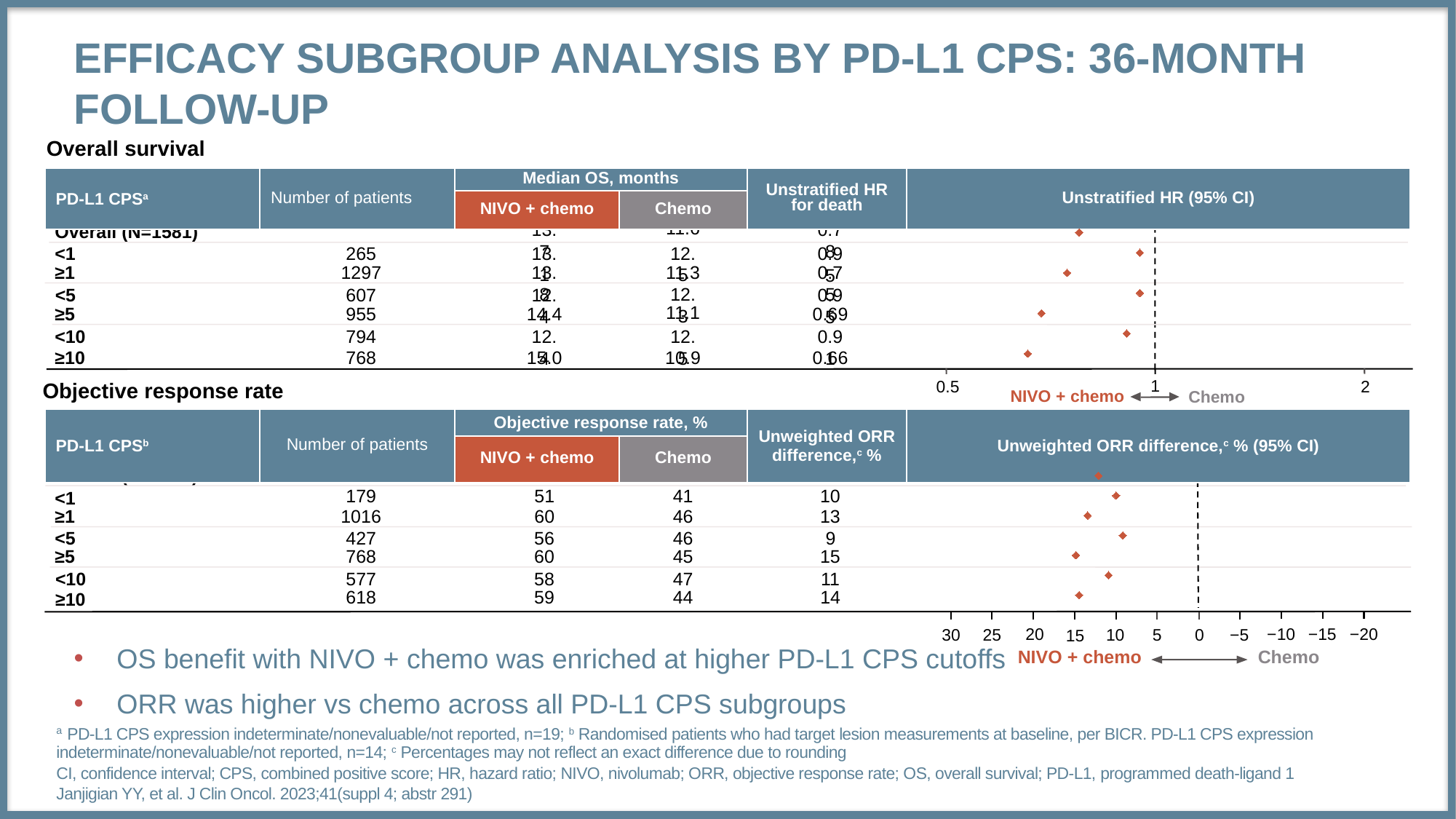
In the Objective response rate table, what is the objective response rate for NIVO + chemo in the PD-L1 CPS ≥10 subgroup? 59 In the Objective response rate table, what is the difference between the NIVO + chemo and Chemo objective response rates for the PD-L1 CPS <1 subgroup? 10 In the Overall survival table, how many patients are in the PD-L1 CPS ≥1 subgroup? 1297 In the Objective response rate table, how many patients are in the PD-L1 CPS ≥1 subgroup? 1016 In the Objective response rate table, what is the objective response rate for Chemo in the PD-L1 CPS <1 subgroup? 41 In the Objective response rate chart, which subgroup has the larger unweighted ORR difference, <10 or ≥10? ≥10 In the Overall survival forest plot, is the unstratified HR for death for the PD-L1 CPS ≥10 subgroup greater or less than 1? less In the Objective response rate chart, which PD-L1 CPS subgroup has the lowest unweighted ORR difference? <5 In the Objective response rate chart, what is the unweighted ORR difference for the PD-L1 CPS ≥5 subgroup? 15 In the Overall survival forest plot, is the unstratified HR for death for the PD-L1 CPS ≥5 subgroup greater or less than 1? less In the Objective response rate chart, which PD-L1 CPS subgroup has the highest unweighted ORR difference? ≥5 In the Objective response rate forest plot, which treatment does the arrow pointing to the left of the dashed line favour? NIVO + chemo